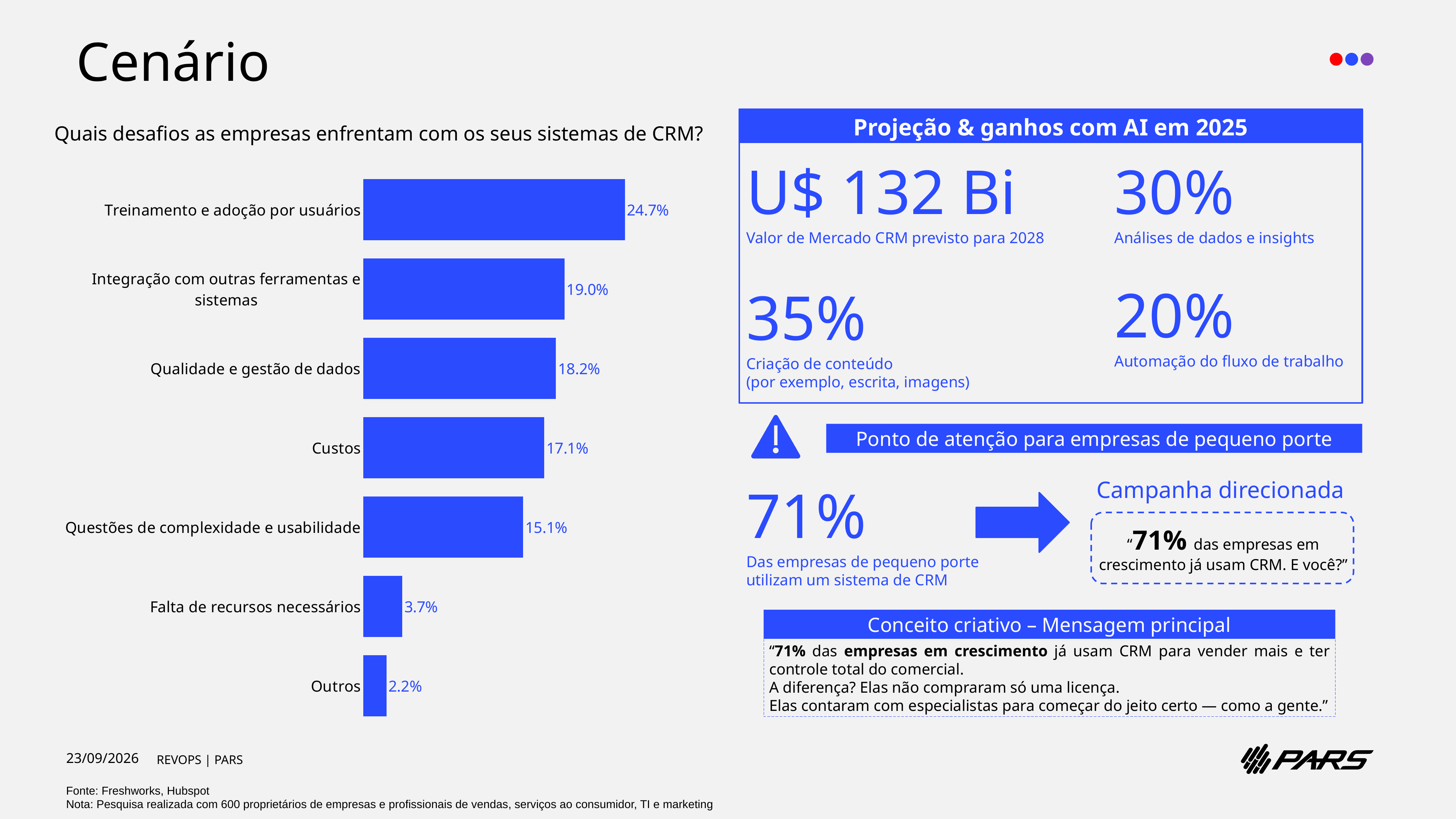
How many categories does the bar chart show? 7 What is the value for "Custos"? 17.1% What kind of chart is shown on the slide? Bar chart What is the value for "Treinamento e adoção por usuários"? 24.7% What question does the chart title ask? Quais desafios as empresas enfrentam com os seus sistemas de CRM? What colour are the bars in the chart? Blue Which category has the highest value? Treinamento e adoção por usuários Which is larger, "Questões de complexidade e usabilidade" or "Custos"? Custos Which category has the lowest value? Outros What is the difference between "Integração com outras ferramentas e sistemas" and "Qualidade e gestão de dados"? 0.8% What is the value for "Falta de recursos necessários"? 3.7% What is the difference between "Treinamento e adoção por usuários" and "Outros"? 22.5%